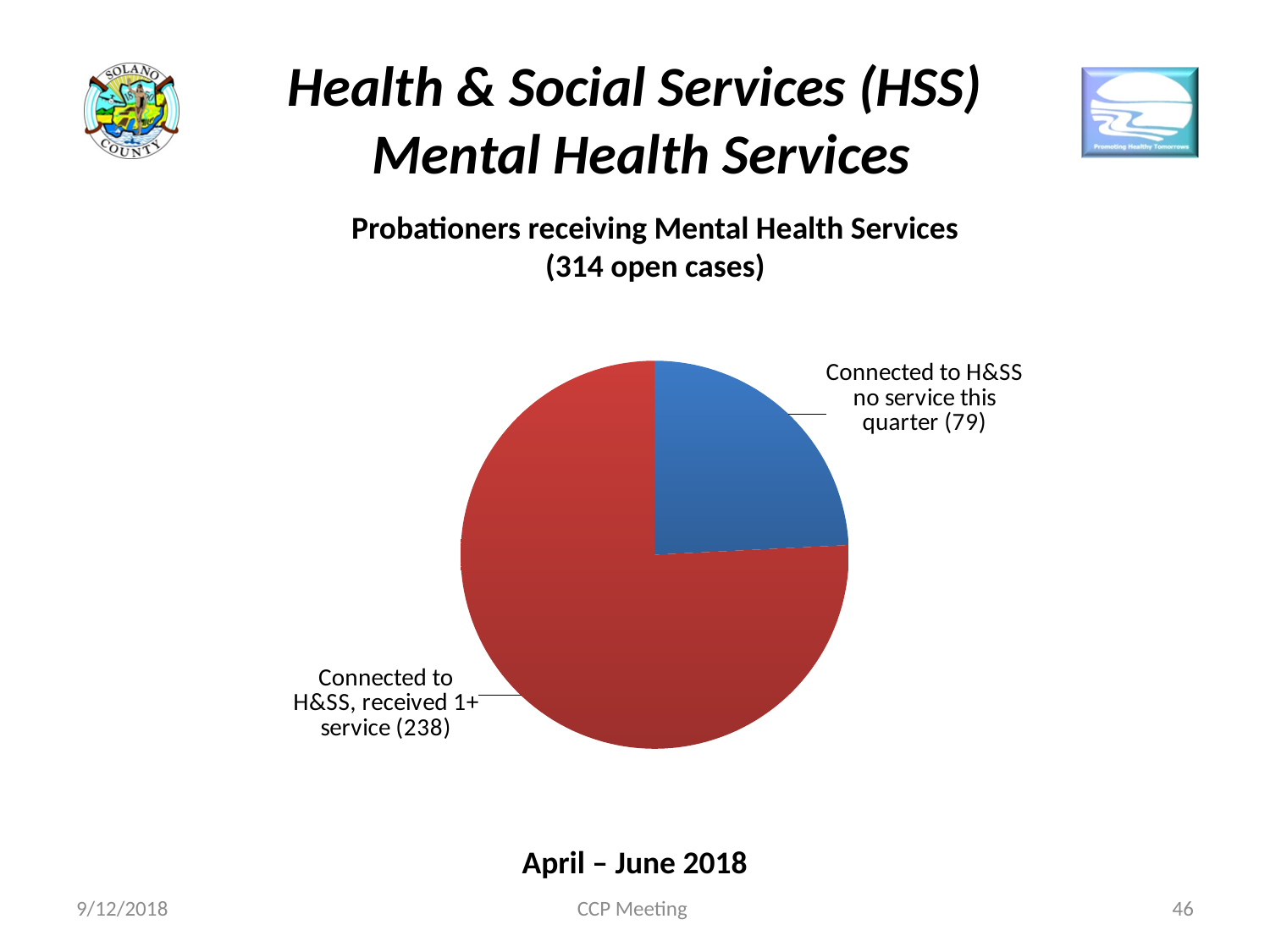
What is the title of the chart? Probationers receiving Mental Health Services (314 open cases) What time period does the chart cover, according to the caption below it? April – June 2018 Which is larger: the number connected to H&SS with no service this quarter, or the number connected to H&SS who received 1+ service? Connected to H&SS, received 1+ service How many probationers were connected to H&SS and received 1+ service? 238 What colour is the slice for probationers connected to H&SS who received 1+ service? Red What kind of chart is shown on the slide? Pie chart Which slice of the pie is the smallest? Connected to H&SS no service this quarter How many slices does the pie chart have? 2 Which slice of the pie is the largest? Connected to H&SS, received 1+ service How many more probationers received 1+ service than received no service this quarter? 159 How many probationers were connected to H&SS but received no service this quarter? 79